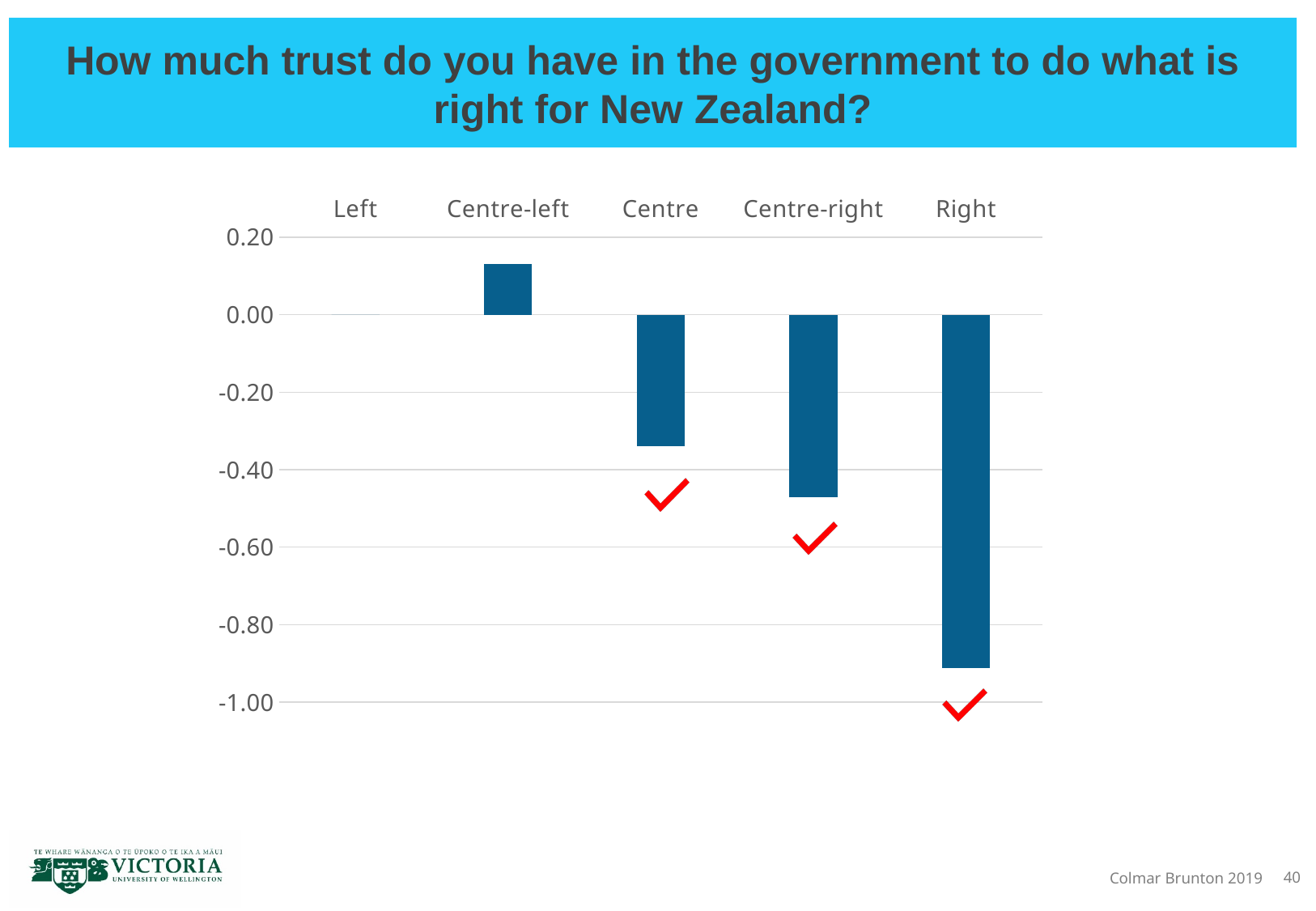
Which has the larger value, Centre or Right? Centre Do the values rise or fall moving from Centre-left to Right along the x axis? fall Which category has the highest value in the chart? Centre-left Is the value for Centre-right greater or less than -0.40? less What kind of chart is shown on the slide? bar chart Is the value for Centre-left greater or less than 0.00? greater Is the value for Centre greater or less than -0.20? less What is the title of the slide containing the chart? How much trust do you have in the government to do what is right for New Zealand? How many categories are shown on the x axis of the chart? 5 Which category has the lowest value in the chart? Right